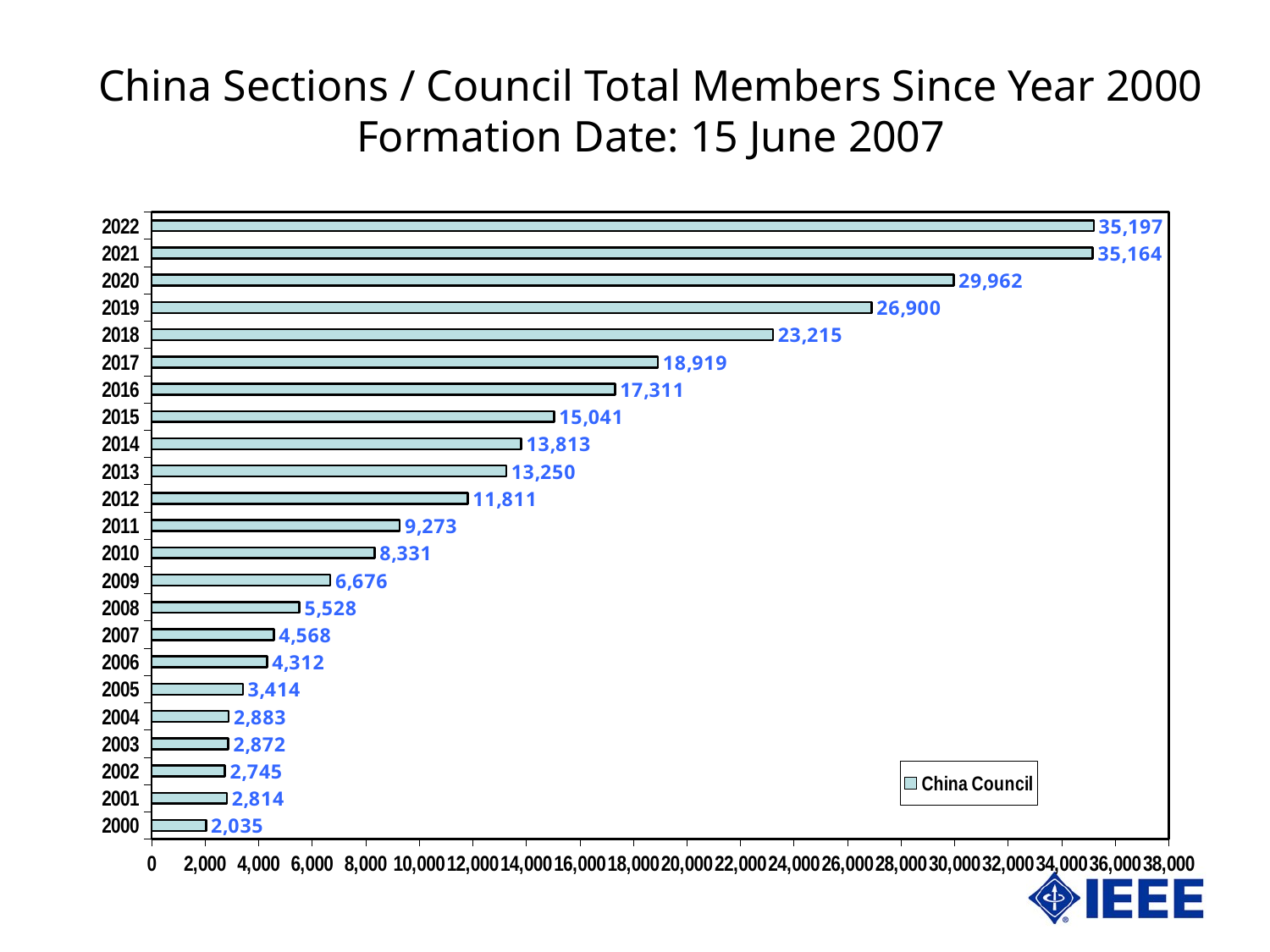
How many years are shown on the chart? 23 What is the value shown for the year 2000? 2,035 Is the value for 2018 greater or less than 22,000? greater Which year has more members, 2002 or 2001? 2001 What is the difference in members between 2020 and 2019? 3,062 What is the name of the series shown in the legend? China Council What kind of chart is shown on the slide? Bar chart Which year has the lowest number of members? 2000 How many series does the legend list? 1 Which year has the highest number of members? 2022 What is the total number of China Council members in 2015? 15,041 What is the difference in members between 2022 and 2021? 33